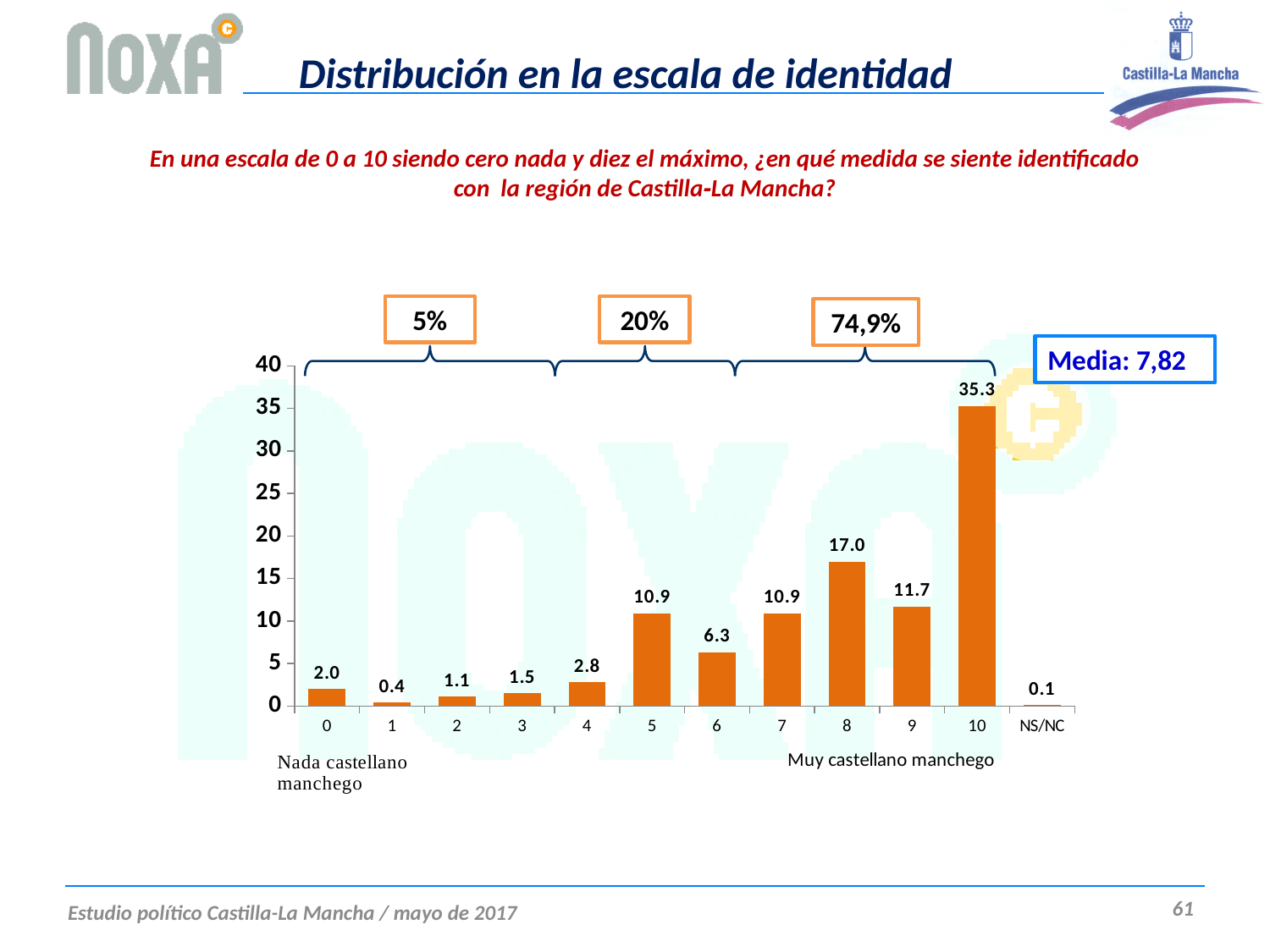
What is the value for category 4? 2.8 What is the value for category 8? 17.0 Which category has the highest value? 10 What is the value for NS/NC? 0.1 What percentage is shown in the box above categories 7 to 10? 74,9% What kind of chart is shown? bar chart What is the difference between the values for category 10 and category 8? 18.3 Which category has the lowest value? NS/NC What is the mean (Media) shown on the slide? 7,82 What is the value for category 10? 35.3 How many categories are shown on the x axis? 12 Which is larger, the value for category 9 or the value for category 6? 9